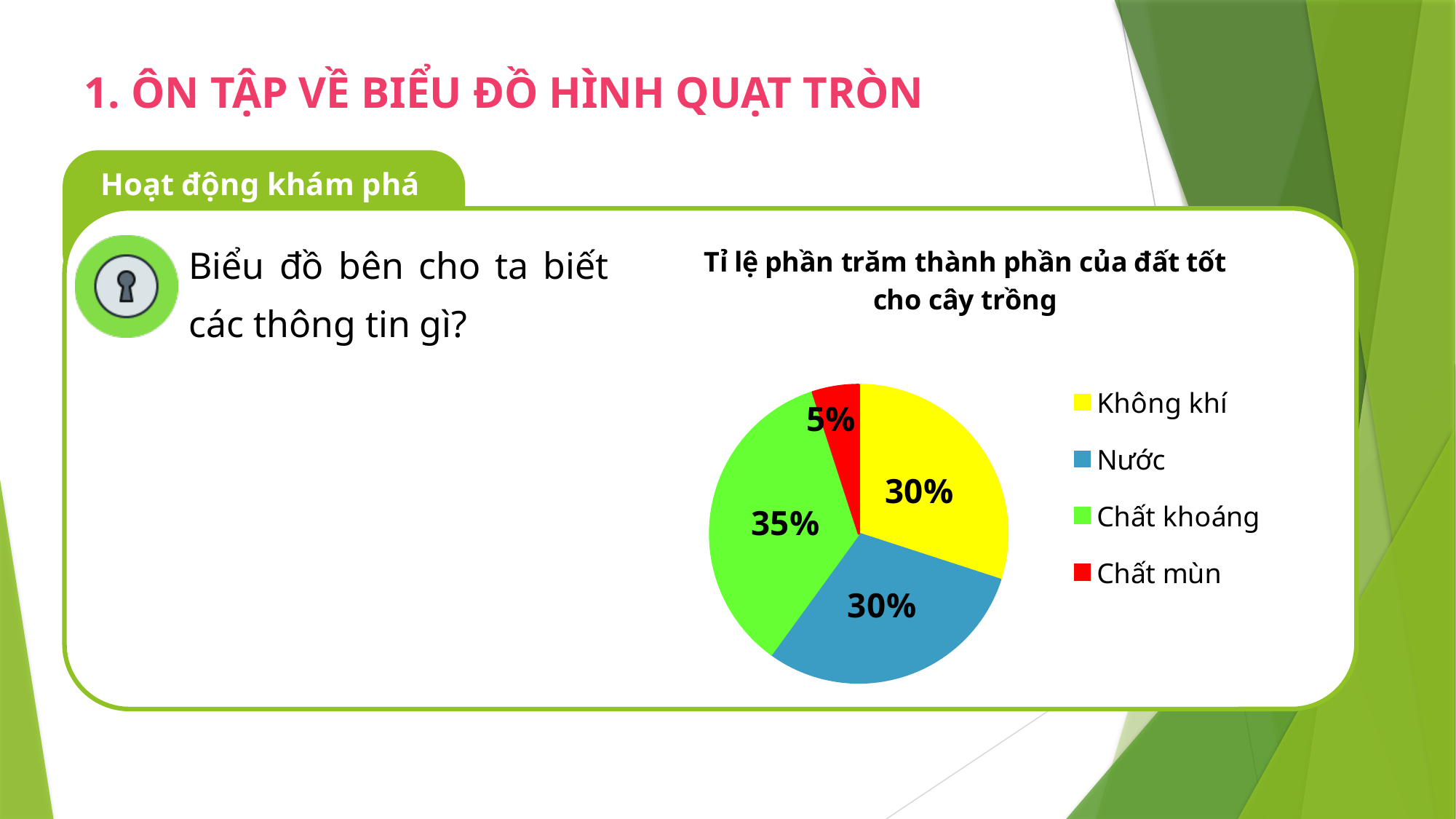
How many categories does the legend list? 4 What percentage does the Không khí slice represent? 30% What kind of chart is shown on the slide? pie chart Which category has the smallest share of the pie? Chất mùn What colour is the Chất mùn slice? red Which category has the largest share of the pie? Chất khoáng What percentage does the Chất khoáng slice represent? 35% Which is larger, the share for Chất khoáng or the share for Nước? Chất khoáng What is the title of the pie chart? Tỉ lệ phần trăm thành phần của đất tốt cho cây trồng What is the difference in percentage points between Chất khoáng and Chất mùn? 30 What percentage does the Chất mùn slice represent? 5% What percentage does the Nước slice represent? 30%